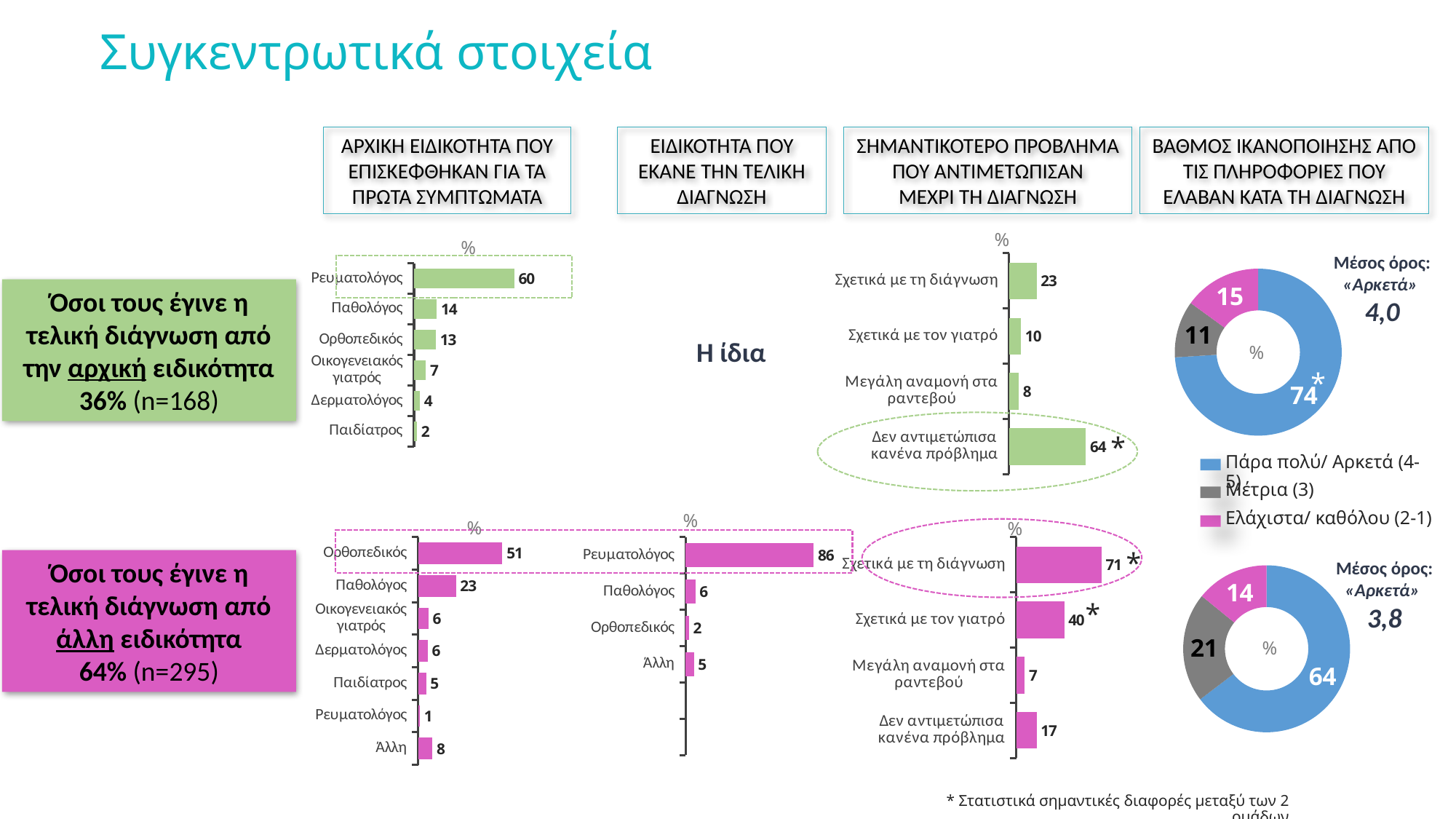
In the bottom-row bar chart for the most important problem faced until diagnosis, what is the value for Μεγάλη αναμονή στα ραντεβού? 7 How many entries does the legend of the satisfaction donut charts list? 3 In the bottom-row bar chart for the most important problem faced until diagnosis, which is larger: Σχετικά με τη διάγνωση or Σχετικά με τον γιατρό? Σχετικά με τη διάγνωση In the bottom-row donut chart for satisfaction with information received at diagnosis, what is the value for Μέτρια (3)? 21 In the top-row donut chart for satisfaction with information received at diagnosis, what share is Πάρα πολύ/ Αρκετά (4-5)? 74 In the top-row bar chart for initial specialty visited (diagnosis by the initial specialty group), which category has the lowest value? Παιδίατρος In the bottom-row bar chart for the specialty that made the final diagnosis, what is the difference between Ρευματολόγος and Παθολόγος? 80 In the bottom-row bar chart for initial specialty visited (diagnosis by another specialty group), how many categories are shown? 7 In the bottom-row bar chart for the specialty that made the final diagnosis, what is the value for Ρευματολόγος? 86 In the top-row bar chart for the most important problem faced until diagnosis, what is the value for Δεν αντιμετώπισα κανένα πρόβλημα? 64 In the bottom-row bar chart for initial specialty visited (diagnosis by another specialty group), which category has the highest value? Ορθοπεδικός In the top-row bar chart for initial specialty visited for first symptoms (diagnosis by the initial specialty group), what is the value for Ρευματολόγος? 60